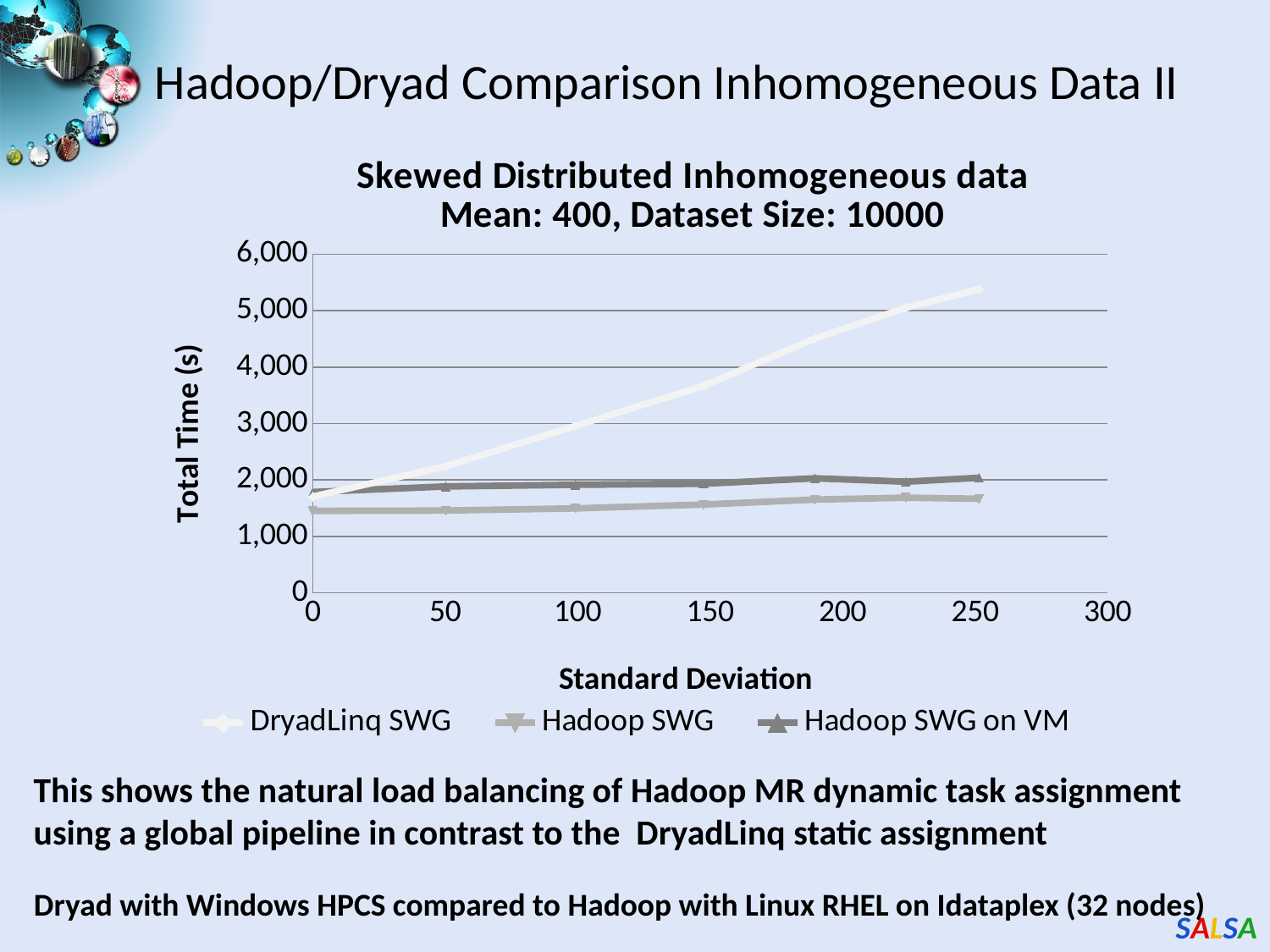
At a standard deviation of 250, which is larger: DryadLinq SWG or Hadoop SWG? DryadLinq SWG Is the value for Hadoop SWG at a standard deviation of 0 greater or less than 2,000? less How many series does the legend list? 3 Is the value for Hadoop SWG at a standard deviation of 250 greater or less than 2,000? less Is the value for DryadLinq SWG at a standard deviation of 0 greater or less than 2,000? less Does the DryadLinq SWG line rise or fall as standard deviation increases? rise What kind of chart is shown on the slide? line chart What is the label of the y axis? Total Time (s) What is the title of the chart? Skewed Distributed Inhomogeneous data Mean: 400, Dataset Size: 10000 Which series reaches the highest total time on the chart? DryadLinq SWG At a standard deviation of 100, which is larger: Hadoop SWG on VM or Hadoop SWG? Hadoop SWG on VM